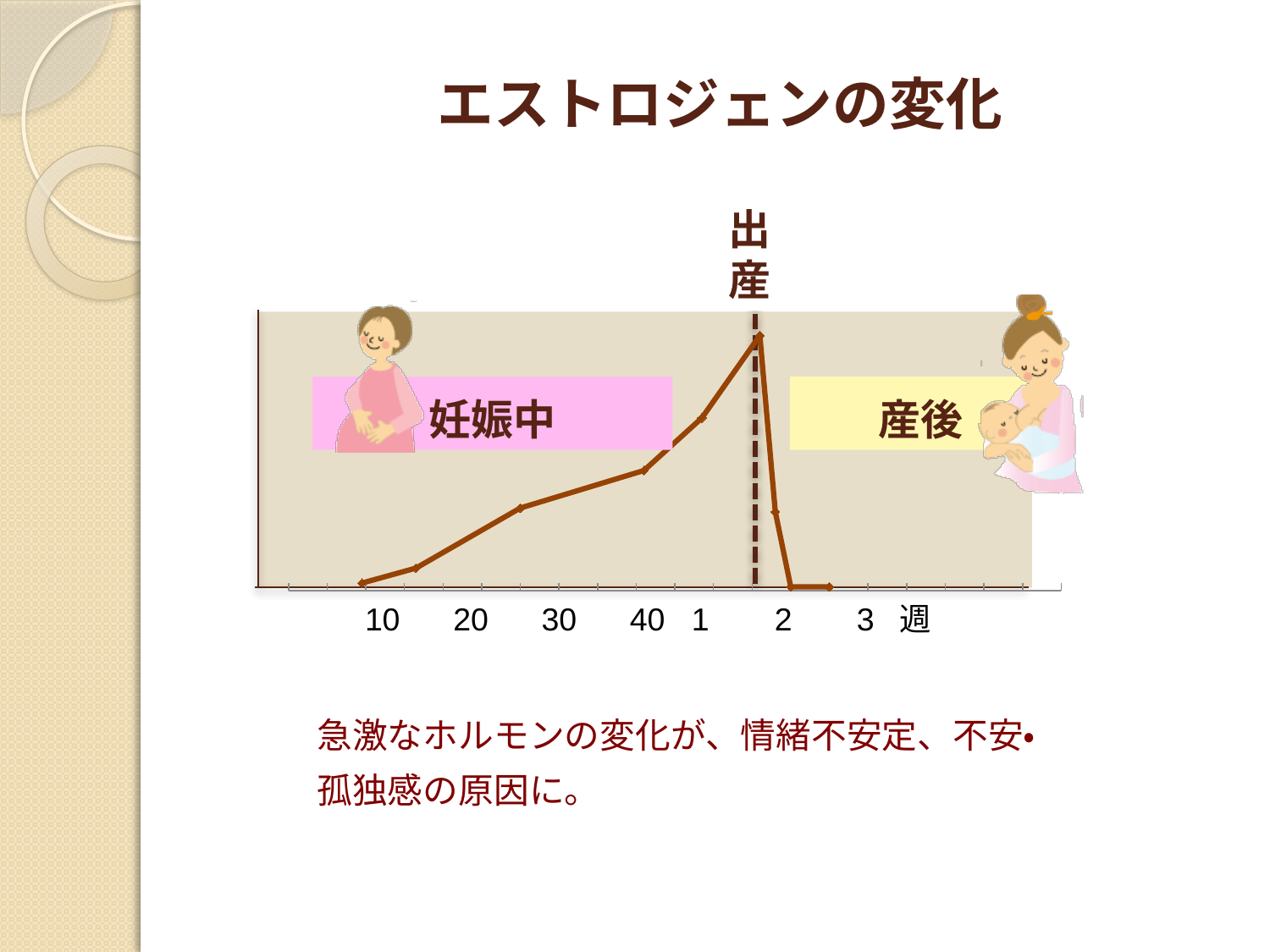
Which is larger, the value at week 30 or the value at week 20? Week 30 What unit is shown at the end of the x axis? 週 How many data series are plotted on the chart? 1 How many data points are marked on the line? 9 What is the title of the chart? エストロジェンの変化 Which is larger, the value at week 40 or the value at week 10? Week 40 Which is larger, the value at 出産 or the value at 3 weeks after birth? 出産 At which point on the x axis does the line reach its highest value? 出産 What are the two labelled periods shown on the chart? 妊娠中 and 産後 Does the line rise or fall after 出産? Fall What kind of chart is shown on the slide? Line chart Does the line rise or fall from week 10 to 出産? Rise